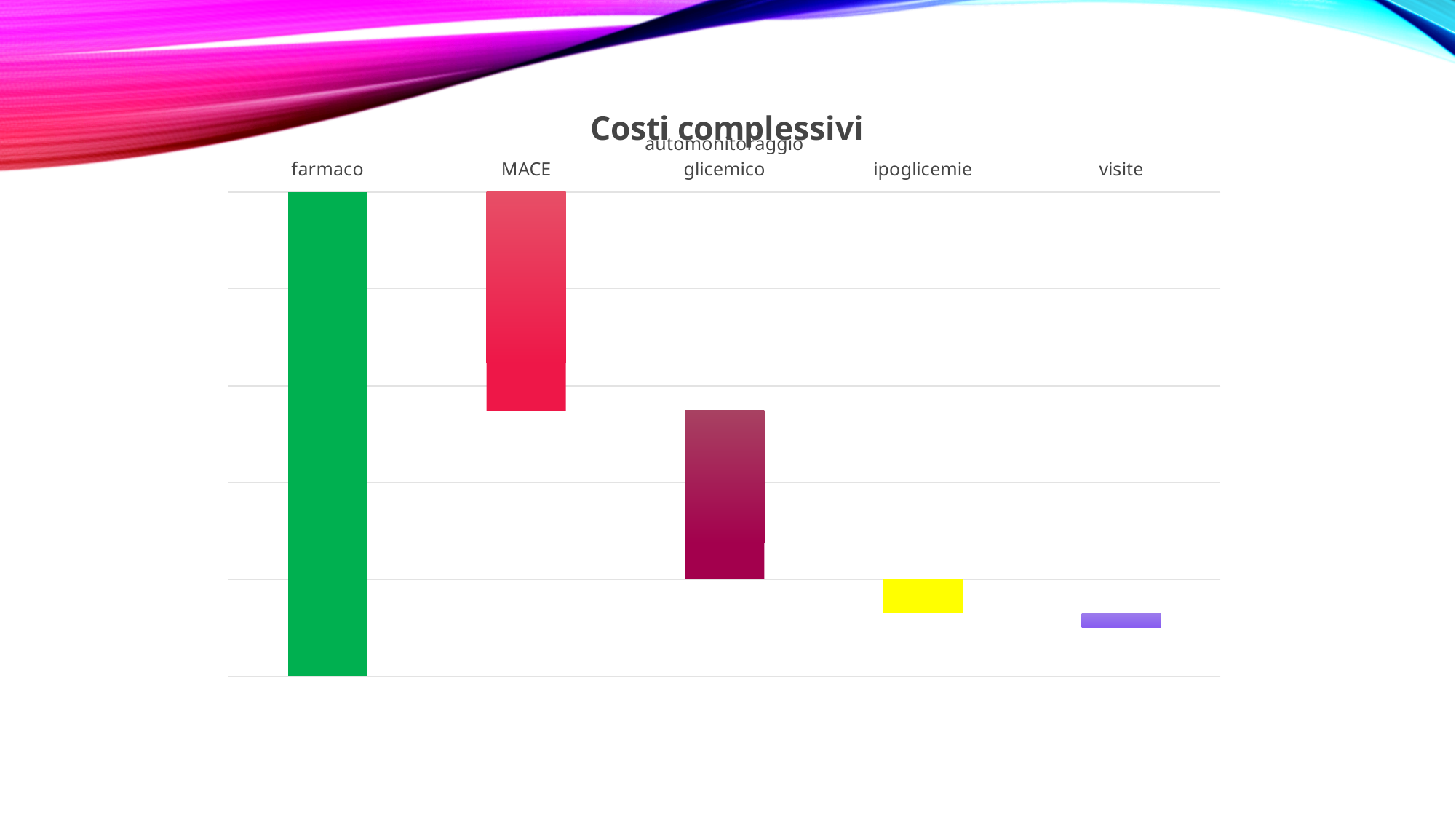
How many categories are shown on the x axis of the chart? 5 Do the bar lengths rise or fall from left to right across the categories? fall Which bar is longer, farmaco or MACE? farmaco Which category has the longest bar in the chart? farmaco Which category has the shortest bar in the chart? visite What is the title of the chart? Costi complessivi What colour is the bar for farmaco? green What kind of chart is shown on the slide? bar chart Which bar is longer, MACE or ipoglicemie? MACE Which bar is longer, automonitoraggio glicemico or visite? automonitoraggio glicemico Which category is the second from the left on the x axis? MACE Which category is shown with a yellow bar? ipoglicemie